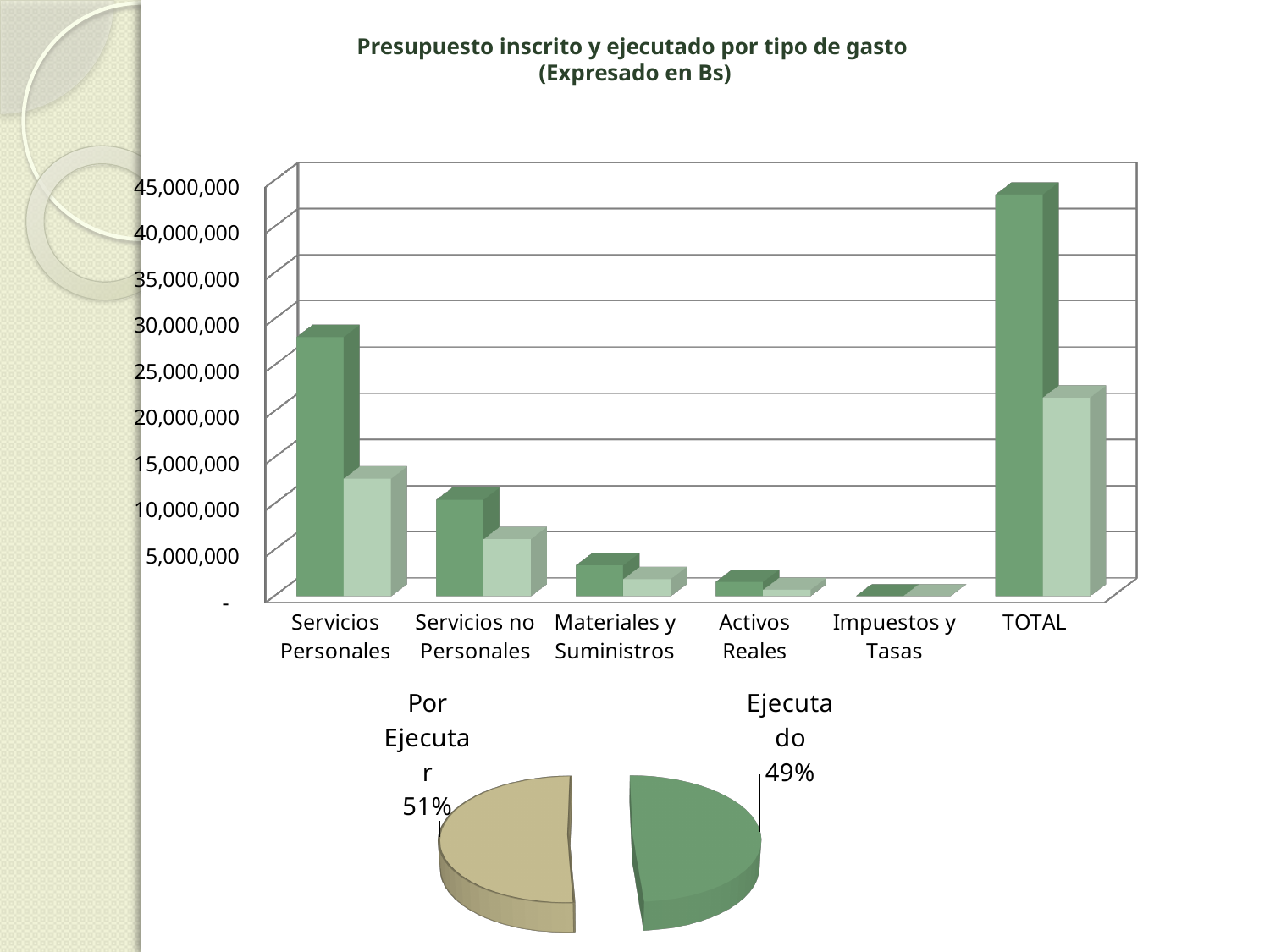
In the top bar chart, which category has the lowest bars? Impuestos y Tasas In the bottom pie chart, what share is labelled 'Ejecutado'? 49% In the top bar chart, is the dark green bar for TOTAL greater or less than 40,000,000? greater In the top bar chart, which has the taller dark green bar: Servicios Personales or Servicios no Personales? Servicios Personales In the top bar chart, how many categories are shown on the x axis? 6 What type of chart is the bottom chart with the 'Por Ejecutar' and 'Ejecutado' slices? pie chart In the bottom pie chart, how many slices are there? 2 In the bottom pie chart, what share is labelled 'Por Ejecutar'? 51% What type of chart is the top chart titled 'Presupuesto inscrito y ejecutado por tipo de gasto'? bar chart In the top bar chart, is the dark green bar for Servicios Personales greater or less than 25,000,000? greater In the top bar chart, is the dark green bar for Materiales y Suministros greater or less than 5,000,000? less In the top bar chart, which category has the tallest bar? TOTAL